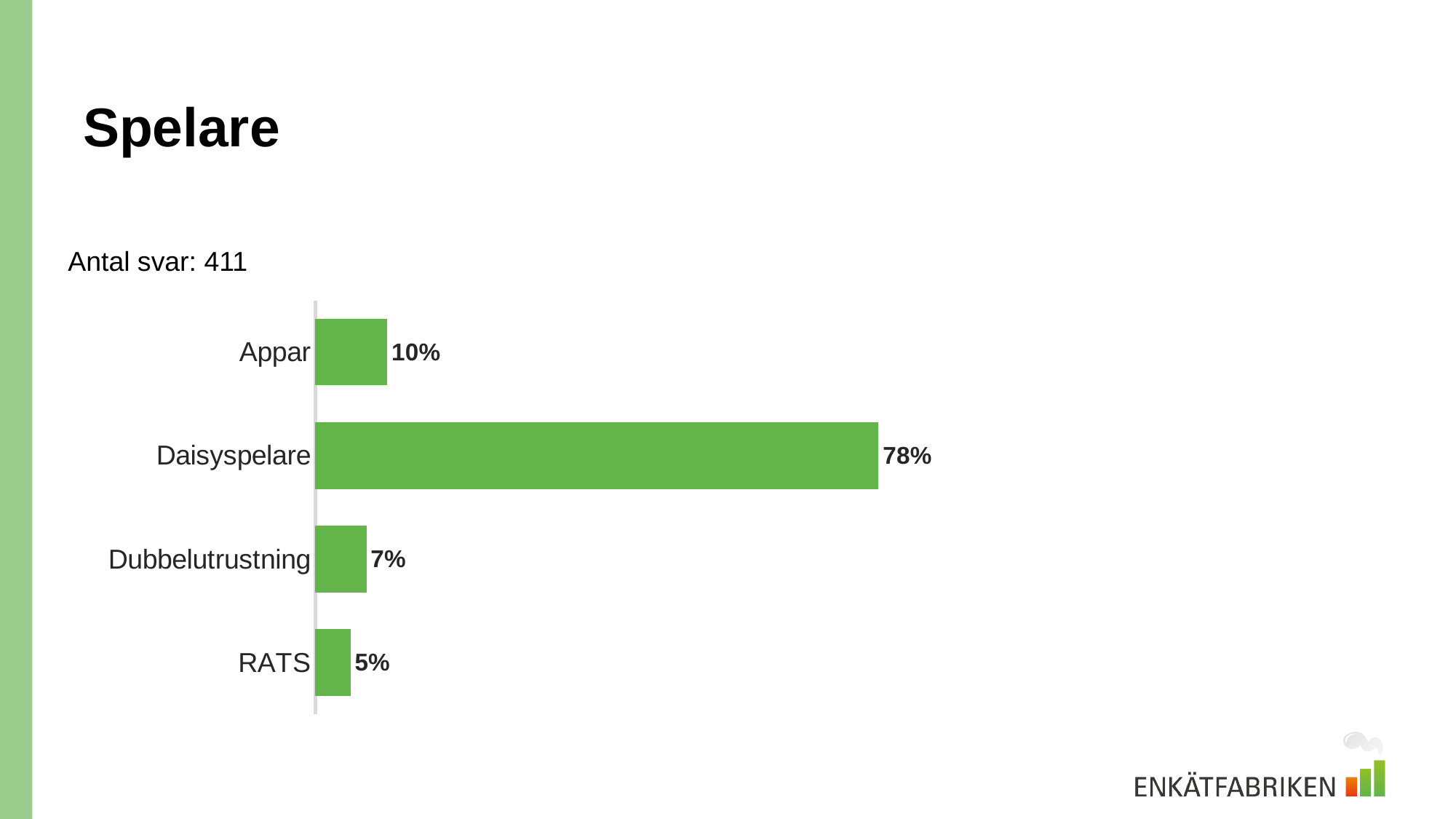
What is the value for RATS? 5% What is the value for Dubbelutrustning? 7% Which category has the highest value? Daisyspelare What is the value for Appar? 10% How many categories are shown in the chart? 4 What is the difference between the values for Dubbelutrustning and RATS? 2% Which is larger, the value for Appar or the value for Dubbelutrustning? Appar What kind of chart is shown on the slide? Bar chart Which category has the lowest value? RATS What is the value for Daisyspelare? 78% How many responses (Antal svar) does the slide report? 411 What is the difference between the values for Daisyspelare and Appar? 68%